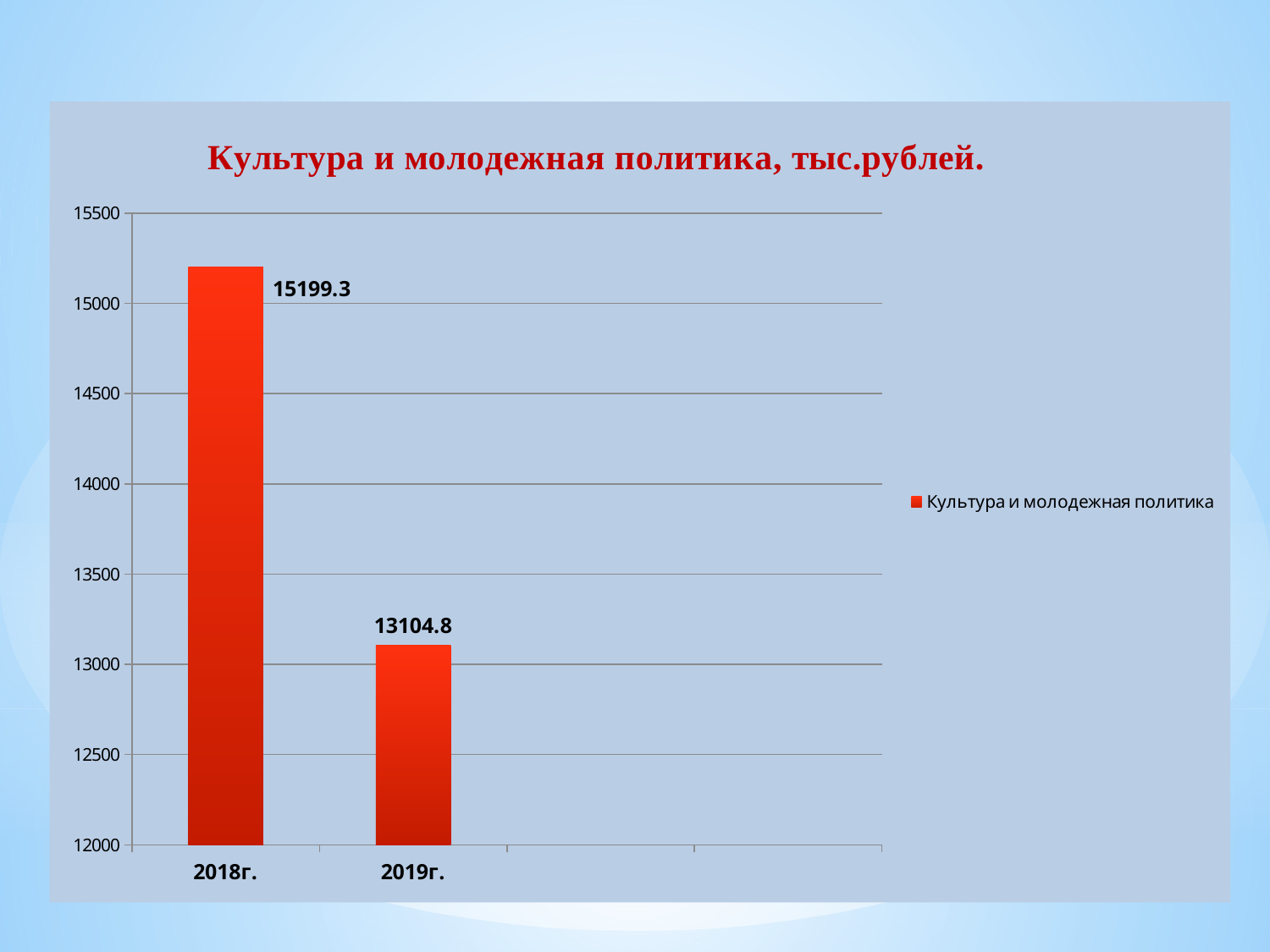
Which is larger, the value for 2018г. or the value for 2019г.? 2018г. What is the difference between the values for 2018г. and 2019г.? 2094.5 Is the value for 2018г. greater or less than 15000? greater Which year has the lowest value? 2019г. How many series does the legend list? 1 Which year has the highest value? 2018г. What is the value for 2018г.? 15199.3 What is the value for 2019г.? 13104.8 What kind of chart is shown? bar chart Is the value for 2019г. greater or less than 13500? less Do the values rise or fall from 2018г. to 2019г.? fall How many categories are shown on the x axis? 2